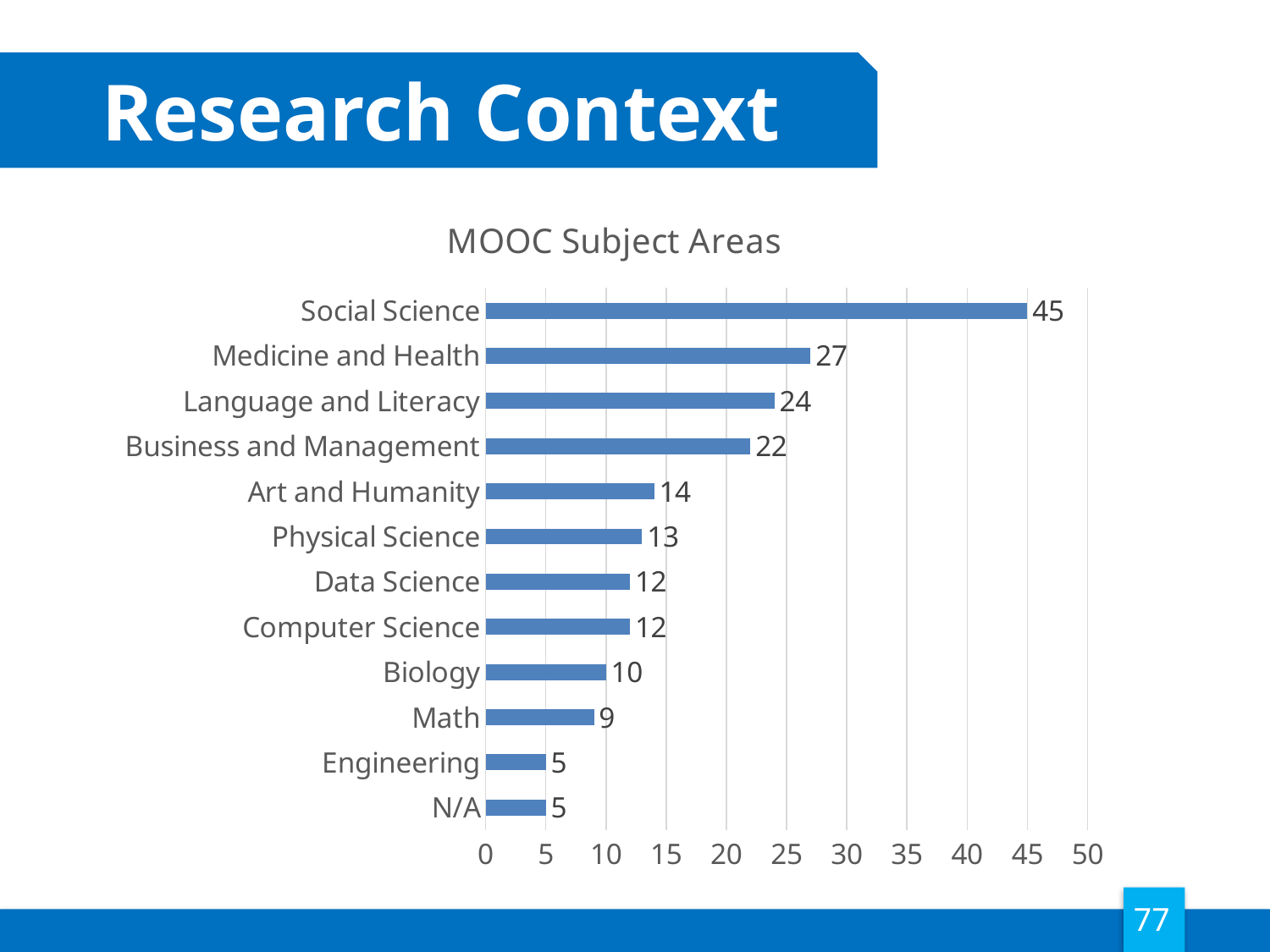
Which is larger, Physical Science or Math? Physical Science What kind of chart is shown on the slide? Bar chart Which subject area has the highest value? Social Science What is the difference between Social Science and Medicine and Health? 18 What is the title of the chart? MOOC Subject Areas What is the difference between Business and Management and Art and Humanity? 8 How many subject areas are shown in the chart? 12 What is the value for Language and Literacy? 24 Is the value for Medicine and Health greater or less than 25? greater What is the value for Social Science? 45 Which two subject areas share the lowest value of 5? Engineering and N/A What is the value for Biology? 10